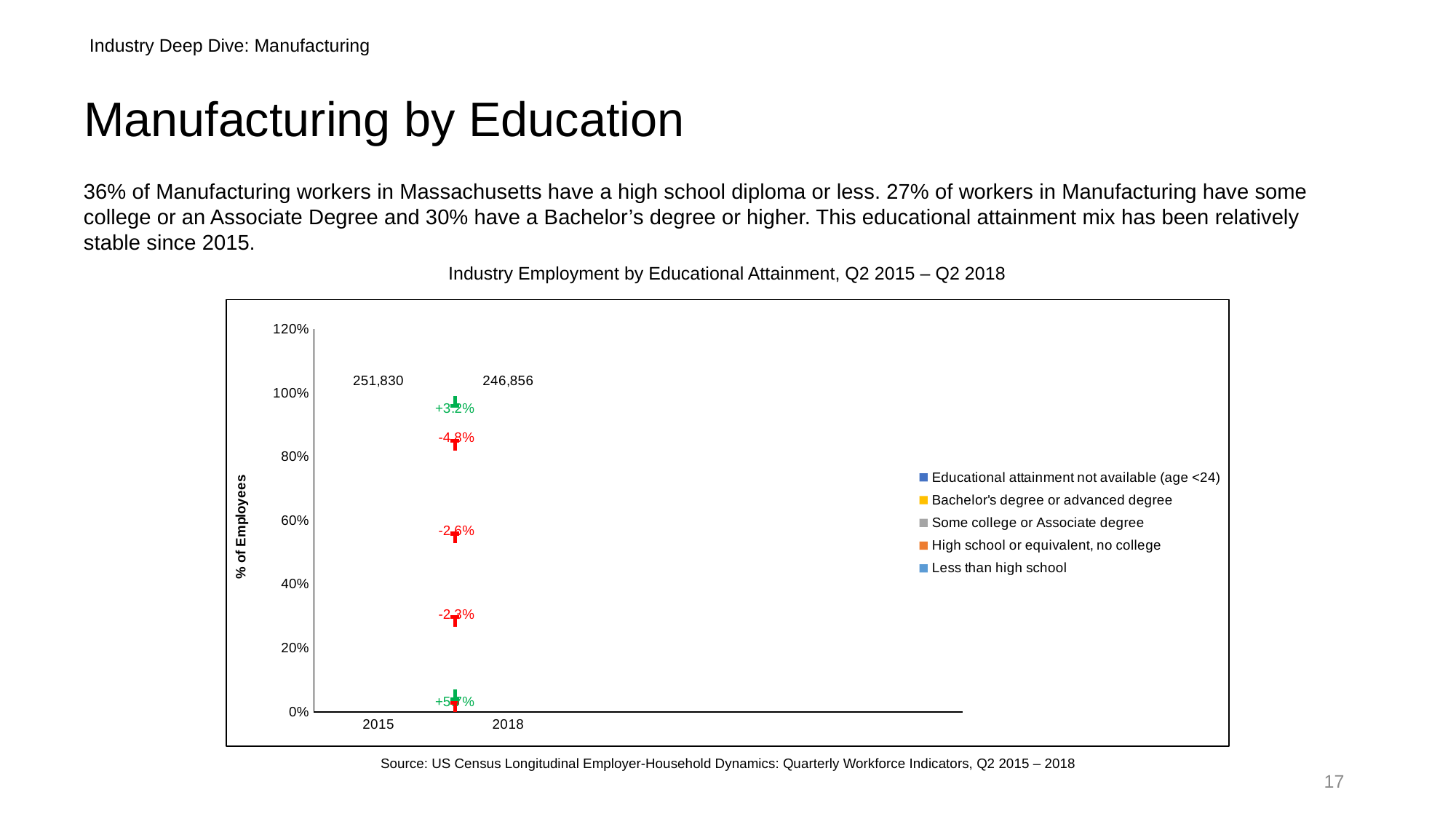
What is the highest value shown on the y axis of the chart? 120% What is the largest negative percentage change label printed on the chart? -4.8% What is the largest positive percentage change label printed on the chart? +5.7% What is the title of the chart? Industry Employment by Educational Attainment, Q2 2015 – Q2 2018 Which year has the larger total employment figure printed on the chart, 2015 or 2018? 2015 What is the label on the y axis of the chart? % of Employees How many series does the chart's legend list? 5 What total employment figure is printed above the 2018 bar? 246,856 What is the difference between the total employment figures printed for 2015 and 2018? 4,974 Does the total employment figure printed on the chart rise or fall from 2015 to 2018? fall How many years are shown on the x axis of the chart? 2 What total employment figure is printed above the 2015 bar? 251,830